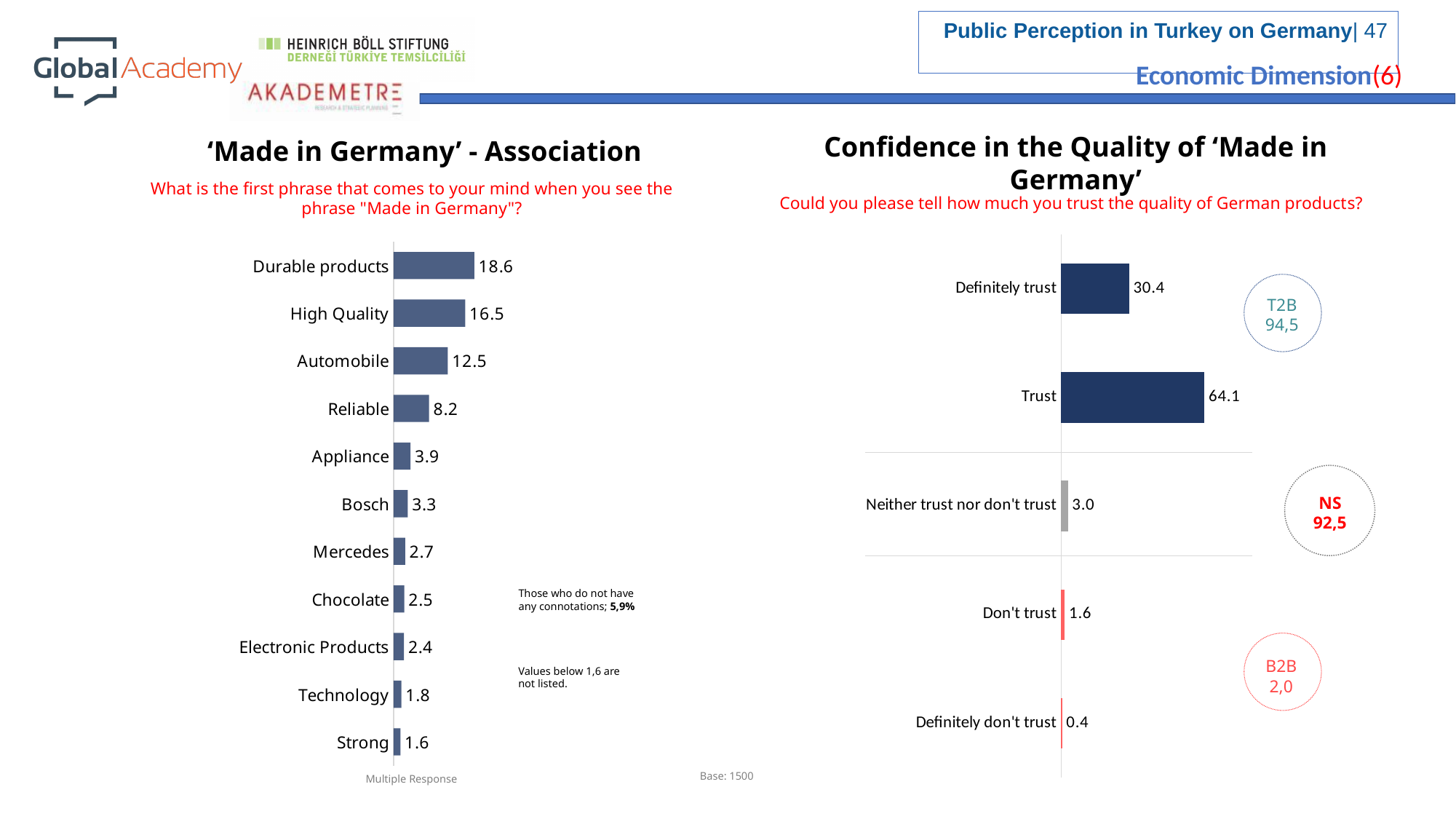
In the Confidence in the Quality of 'Made in Germany' chart, what T2B value is shown in the circle? 94,5 In the 'Made in Germany' - Association chart, what is the value for Automobile? 12.5 In the 'Made in Germany' - Association chart, what is the value for Durable products? 18.6 In the 'Made in Germany' - Association chart, what is the difference between High Quality and Reliable? 8.3 In the Confidence in the Quality of 'Made in Germany' chart, what is the difference between Trust and Definitely trust? 33.7 In the Confidence in the Quality of 'Made in Germany' chart, what is the value for Trust? 64.1 In the 'Made in Germany' - Association chart, which category has the lowest value? Strong In the Confidence in the Quality of 'Made in Germany' chart, which category has the highest value? Trust In the Confidence in the Quality of 'Made in Germany' chart, what is the value for Definitely don't trust? 0.4 What type of chart is the Confidence in the Quality of 'Made in Germany' chart? Bar chart In the 'Made in Germany' - Association chart, which is larger, Bosch or Mercedes? Bosch In the 'Made in Germany' - Association chart, how many categories are shown? 11